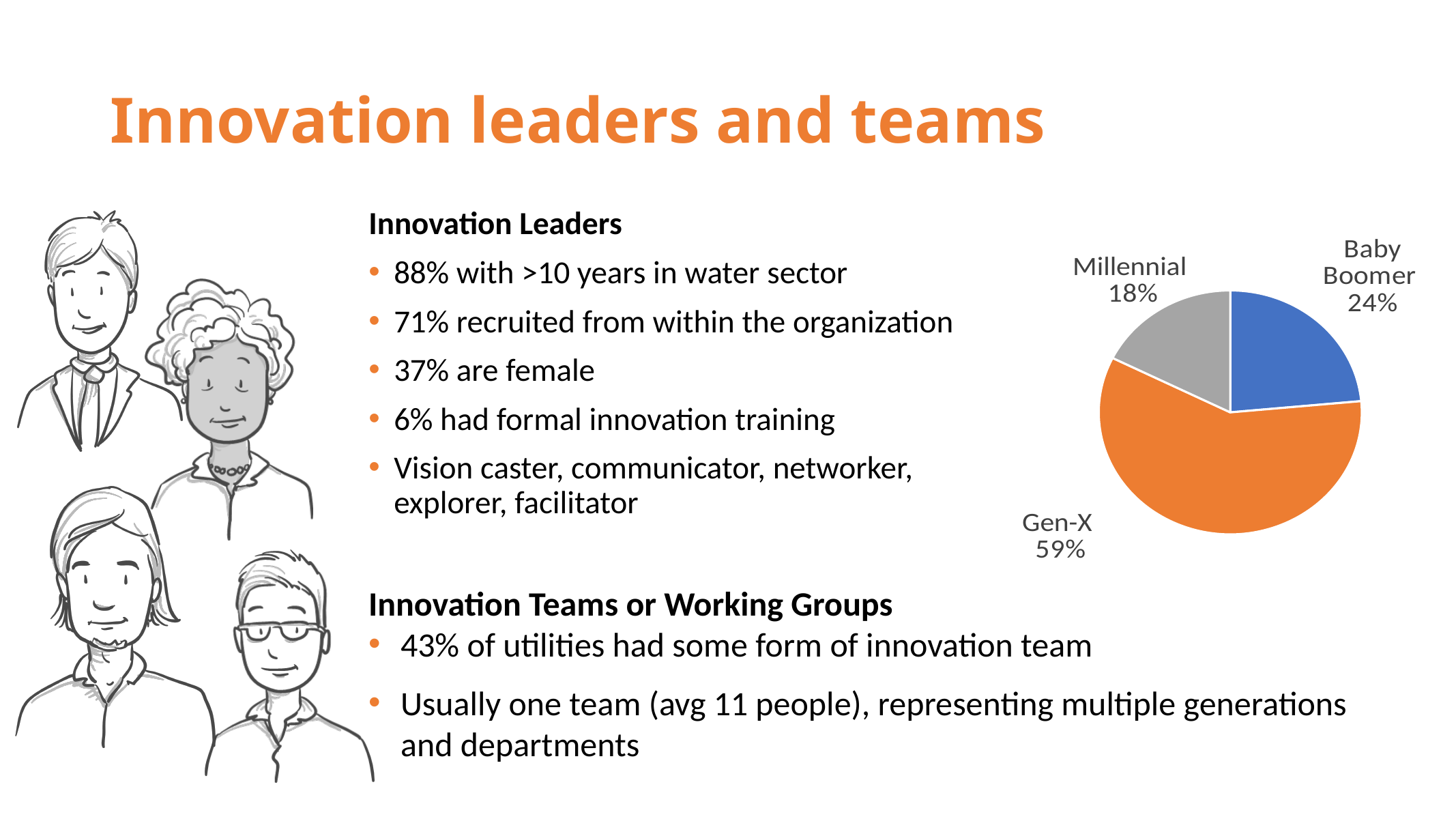
What colour is the Baby Boomer slice of the pie chart? blue What kind of chart is shown on the slide? pie chart What share of the pie chart is Millennial? 18% What is the difference in percentage points between the Gen-X and Baby Boomer slices? 35 How many slices does the pie chart have? 3 Which generation has the smallest slice of the pie chart? Millennial What share of the pie chart is Baby Boomer? 24% Which generation has the largest slice of the pie chart? Gen-X Which slice is larger, Baby Boomer or Millennial? Baby Boomer What colour is the Gen-X slice of the pie chart? orange What share of the pie chart is Gen-X? 59% What is the difference in percentage points between the Baby Boomer and Millennial slices? 6